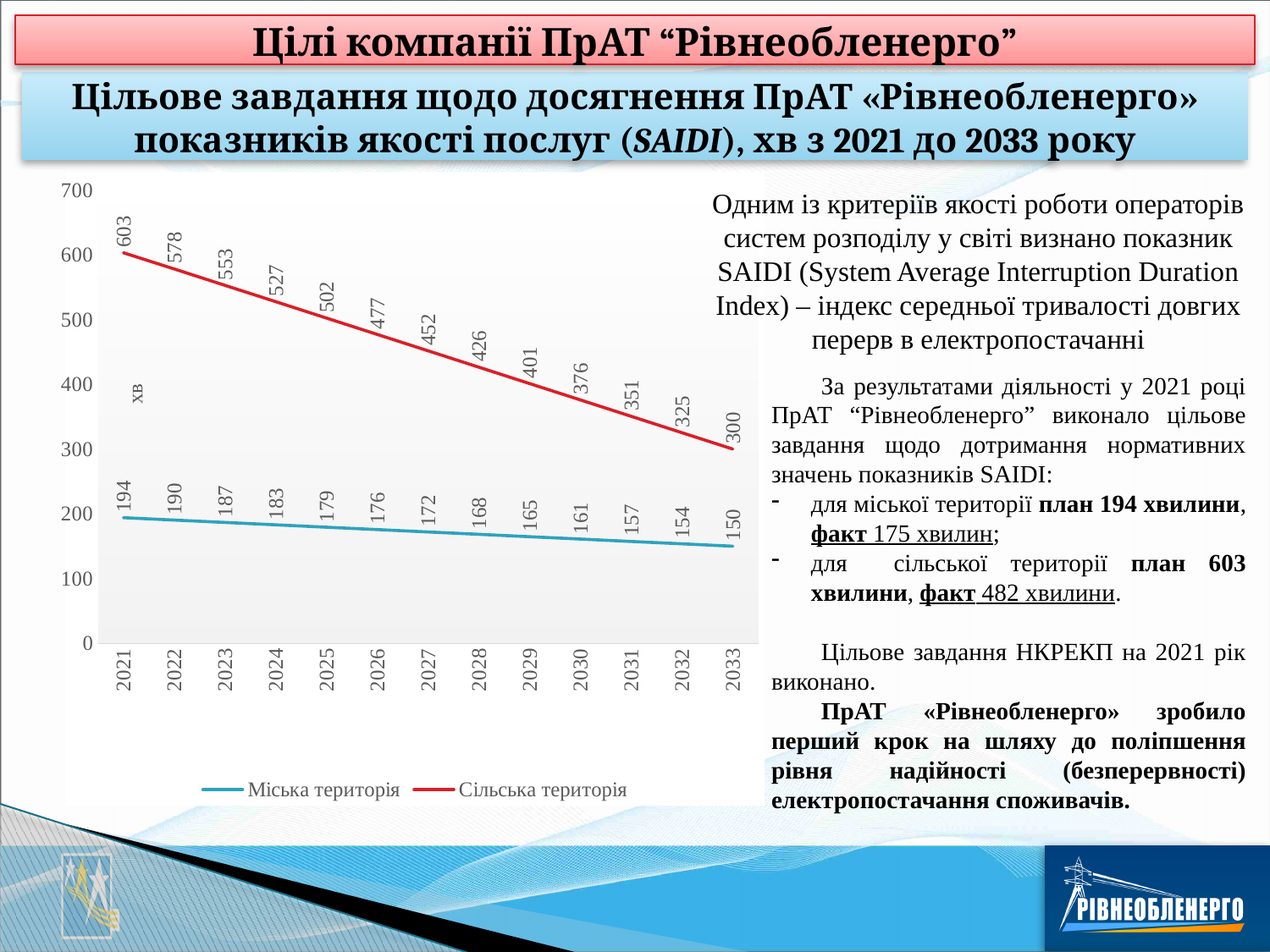
What is the value for Міська територія in 2025? 179 What is the value for Міська територія in 2033? 150 How many years are plotted on the x axis? 13 Which series has the larger value in 2030, Міська територія or Сільська територія? Сільська територія How many series does the chart legend list? 2 What is the value for Сільська територія in 2021? 603 Do the values for Сільська територія rise or fall from 2021 to 2033? fall What is the difference between the Сільська територія values in 2021 and 2033? 303 In which year is the value for Міська територія the highest? 2021 In which year is the value for Сільська територія the lowest? 2033 What type of chart is shown on the slide? line chart What is the value for Сільська територія in 2027? 452